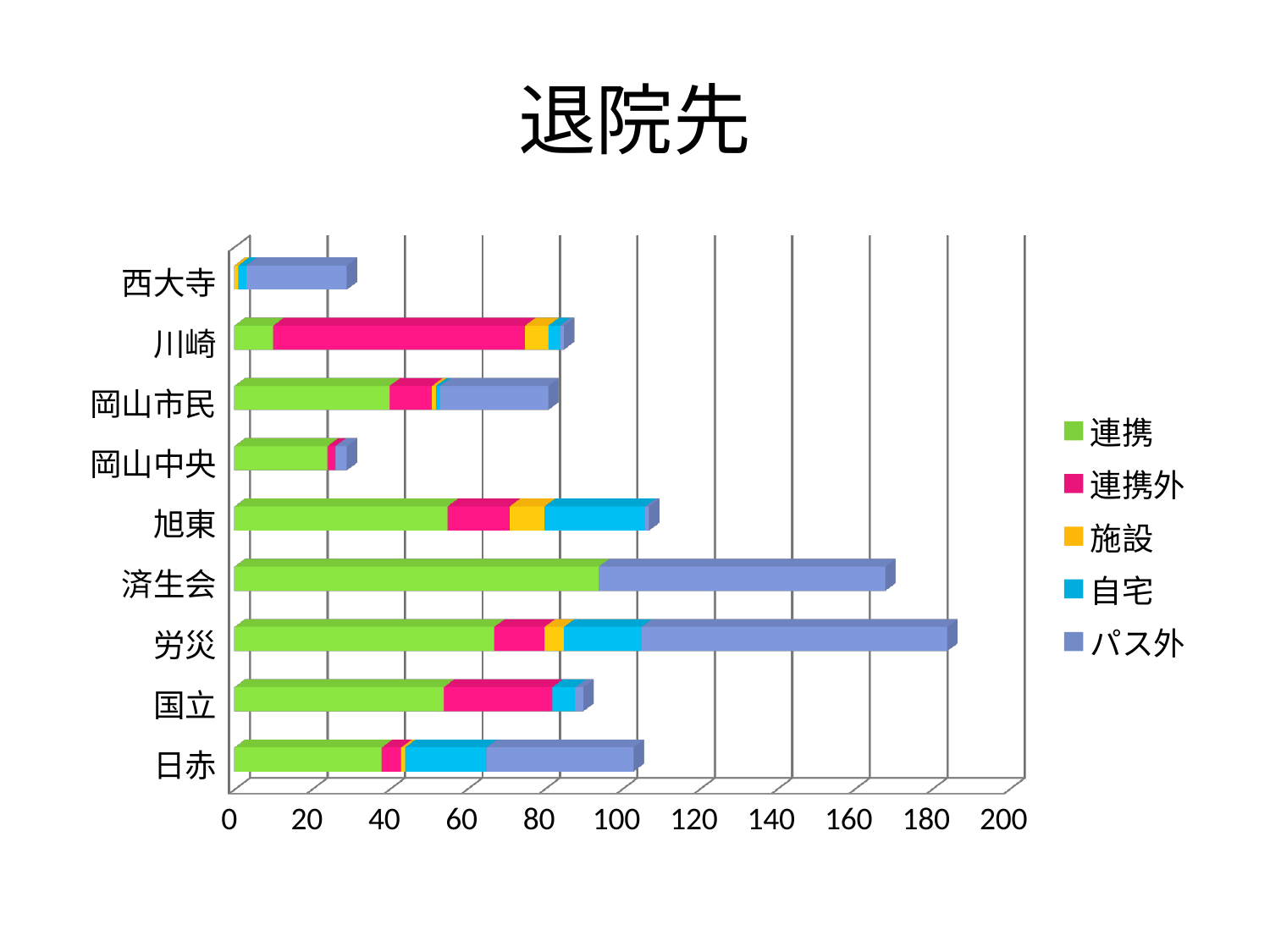
Is the total bar for 川崎 greater or less than 100? less Which series is shown in green in the legend? 連携 Is the total bar for 国立 greater or less than 100? less What kind of chart is shown on the slide? bar chart Is the total bar for 労災 greater or less than 160? greater What is the title of the chart? 退院先 Which has the longer total bar, 済生会 or 旭東? 済生会 Which category has the longest total bar? 労災 How many series does the legend list? 5 How many categories are shown on the vertical axis? 9